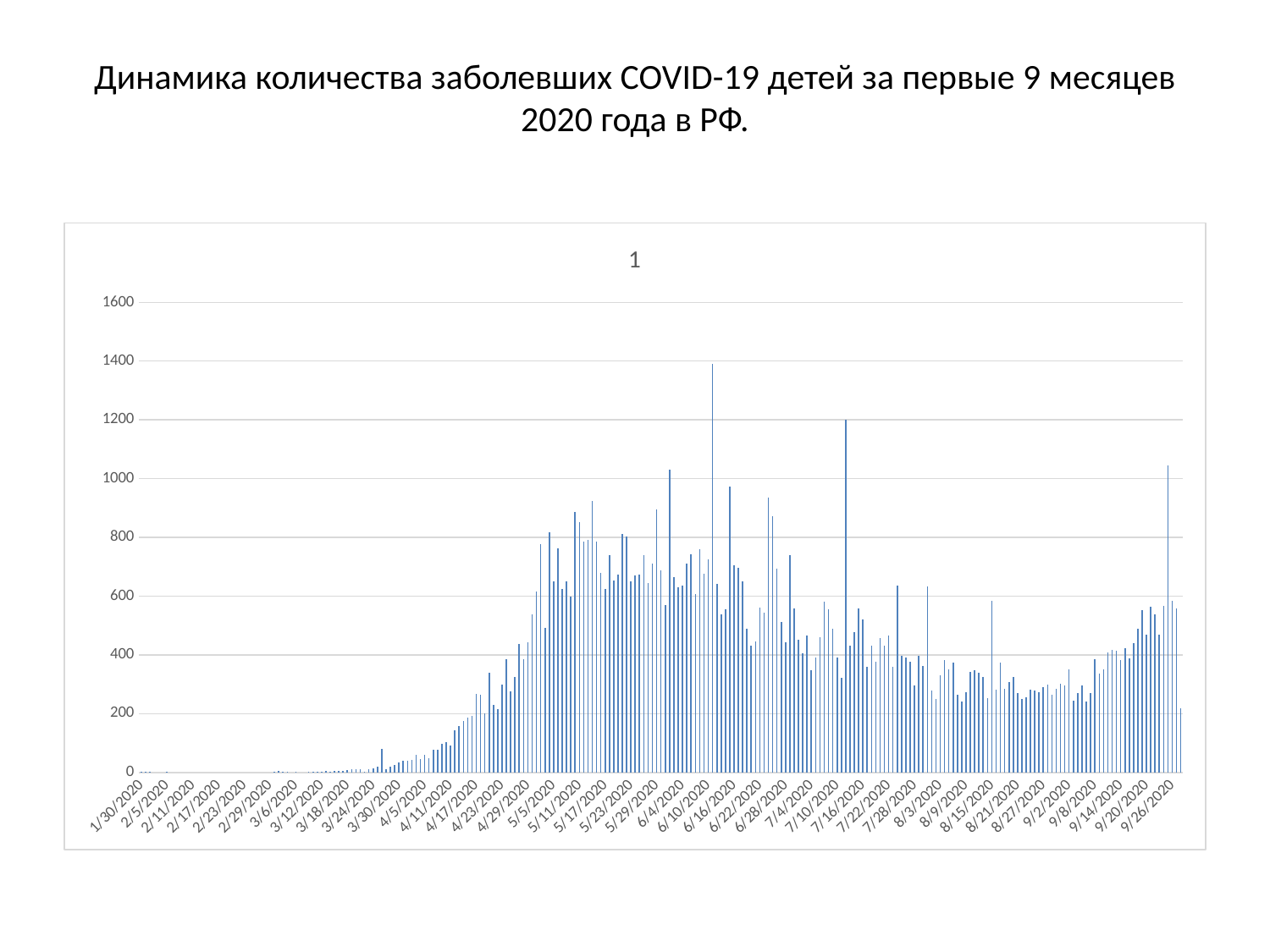
Is the tallest bar on the chart greater or less than 1200? greater Do the values generally rise or fall along the x axis from 6/16/2020 to 8/27/2020? fall Is the value for 9/26/2020 greater or less than 400? greater What kind of chart is shown on the slide? bar chart What is the first date label on the horizontal axis? 1/30/2020 Is the value for 2/5/2020 greater or less than 200? less What is the title printed inside the chart area? 1 What is the highest tick value shown on the vertical axis? 1600 Do the values generally rise or fall along the x axis from 1/30/2020 to 5/5/2020? rise Which is larger, the value for 3/6/2020 or the value for 5/11/2020? 5/11/2020